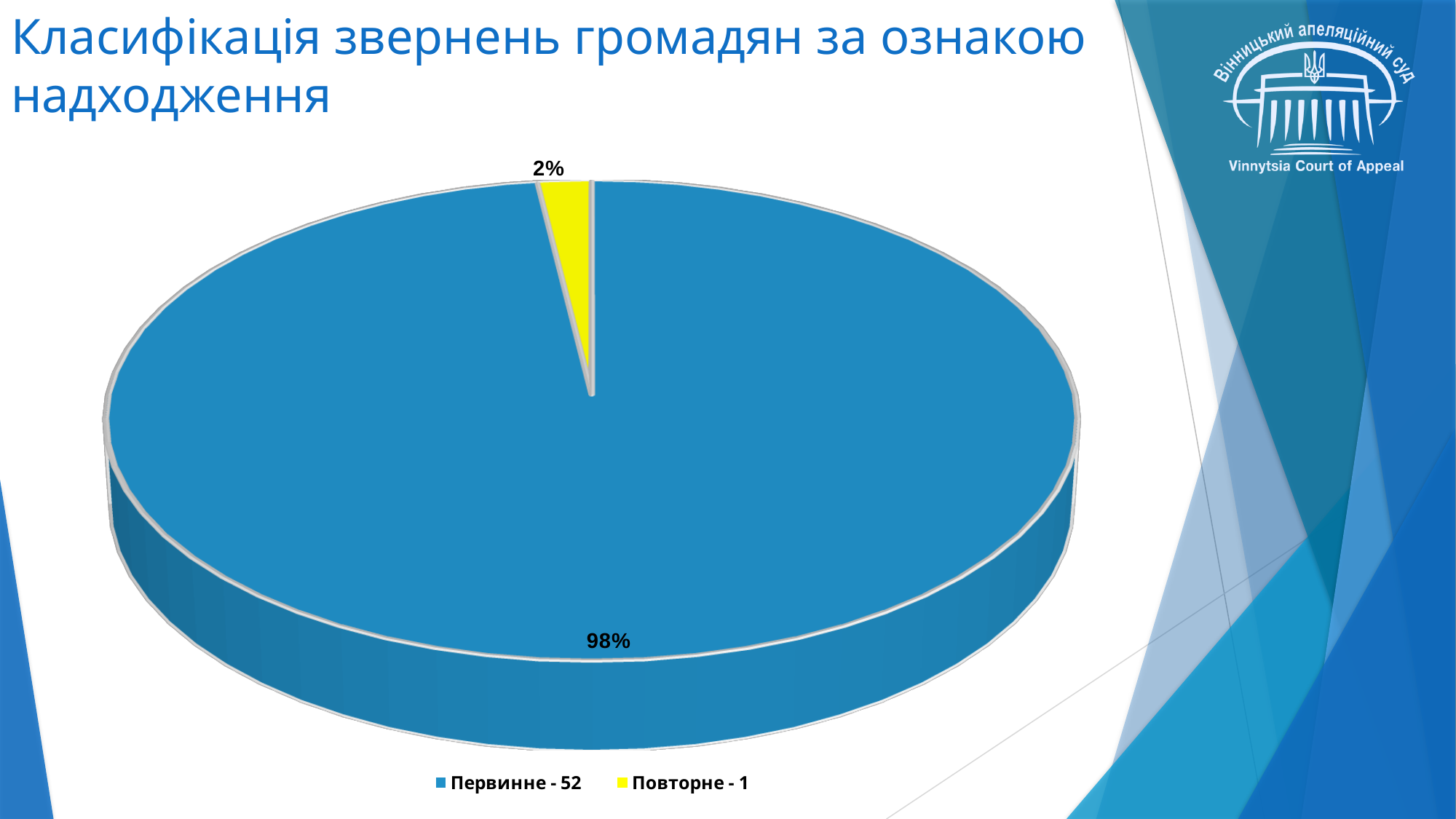
What share of the pie does the "Повторне - 1" slice represent? 2% Which is larger, the share for "Первинне - 52" or the share for "Повторне - 1"? Первинне - 52 What is the difference in percentage points between the "Первинне - 52" share and the "Повторне - 1" share? 96% What is the title of the slide containing the pie chart? Класифікація звернень громадян за ознакою надходження Which category has the largest slice of the pie? Первинне - 52 How many slices does the pie chart have? 2 How many entries does the legend list? 2 What colour is the "Повторне - 1" slice? Yellow Which category has the smallest slice of the pie? Повторне - 1 What share of the pie does the "Первинне - 52" slice represent? 98% What kind of chart is shown on the slide? Pie chart